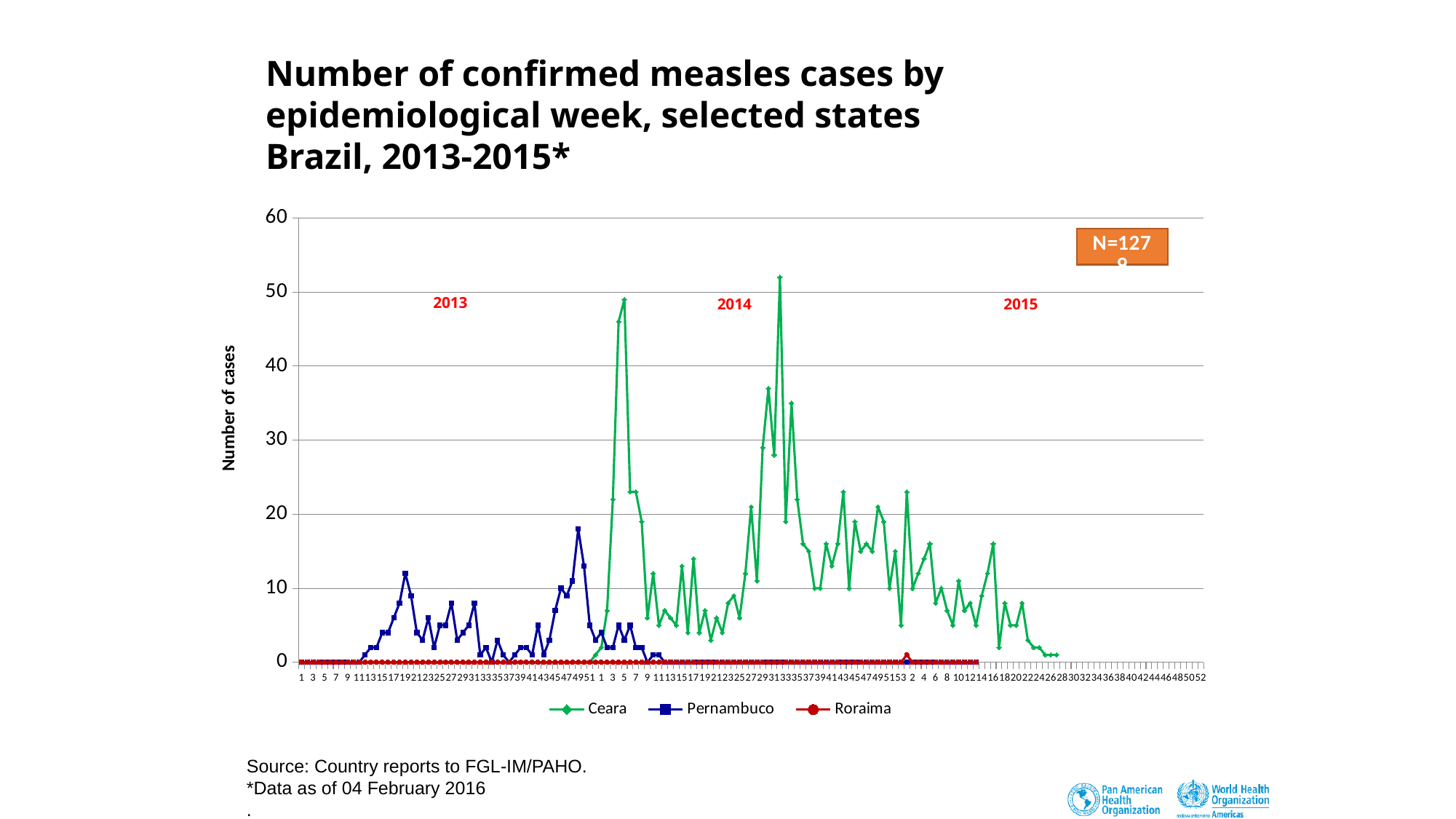
Which states are listed in the chart legend? Ceara, Pernambuco, Roraima Is the highest value for Ceara greater or less than 40? greater What kind of chart is shown on the slide? Line chart How many series does the legend list? 3 Is the highest value for Pernambuco greater or less than 20? less Which series reaches the highest number of cases in the chart? Ceara What is the label of the vertical axis? Number of cases Do the Ceara values rise or fall over the course of 2015? fall Is the highest value for Roraima greater or less than 10? less Which series has the lowest values throughout the chart? Roraima In which year does Pernambuco show its highest number of cases? 2013 Which series has the higher peak, Ceara or Pernambuco? Ceara